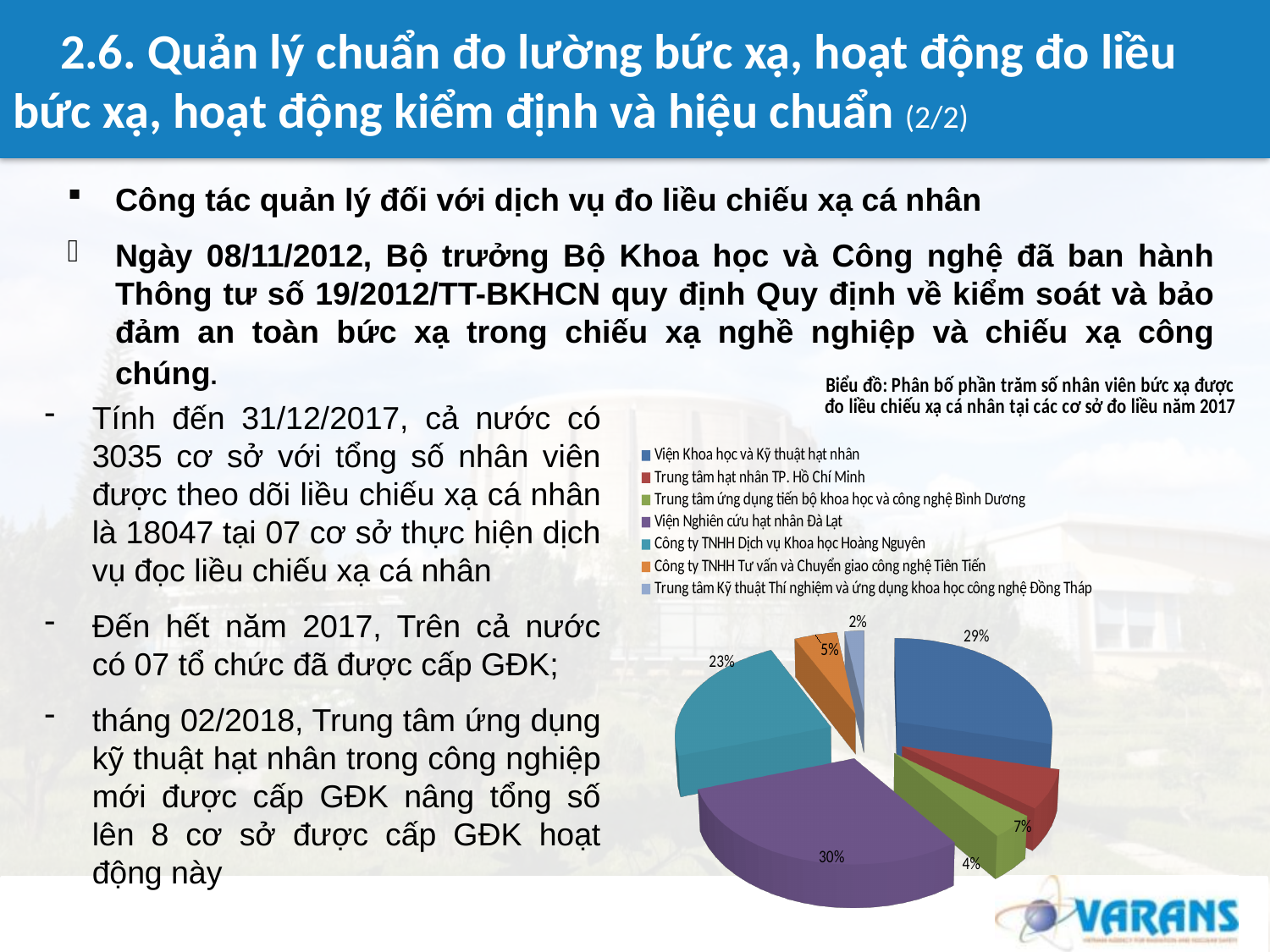
Which organisation has the largest share in the pie chart? Viện Nghiên cứu hạt nhân Đà Lạt What percentage of the pie chart is for Trung tâm hạt nhân TP. Hồ Chí Minh? 7% What percentage of the pie chart is for Viện Khoa học và Kỹ thuật hạt nhân? 29% What kind of chart is shown on the slide? pie chart What percentage of the pie chart is for Viện Nghiên cứu hạt nhân Đà Lạt? 30% What year does the pie chart's title say the data is for? 2017 How many slices does the pie chart have? 7 Which has the larger share in the pie chart, Công ty TNHH Tư vấn và Chuyển giao công nghệ Tiên Tiến or Trung tâm ứng dụng tiến bộ khoa học và công nghệ Bình Dương? Công ty TNHH Tư vấn và Chuyển giao công nghệ Tiên Tiến What percentage of the pie chart is for Công ty TNHH Dịch vụ Khoa học Hoàng Nguyên? 23% What is the difference in percentage points between the shares of Viện Nghiên cứu hạt nhân Đà Lạt and Công ty TNHH Dịch vụ Khoa học Hoàng Nguyên? 7 How many entries does the legend of the pie chart list? 7 Which organisation has the smallest share in the pie chart? Trung tâm Kỹ thuật Thí nghiệm và ứng dụng khoa học công nghệ Đồng Tháp